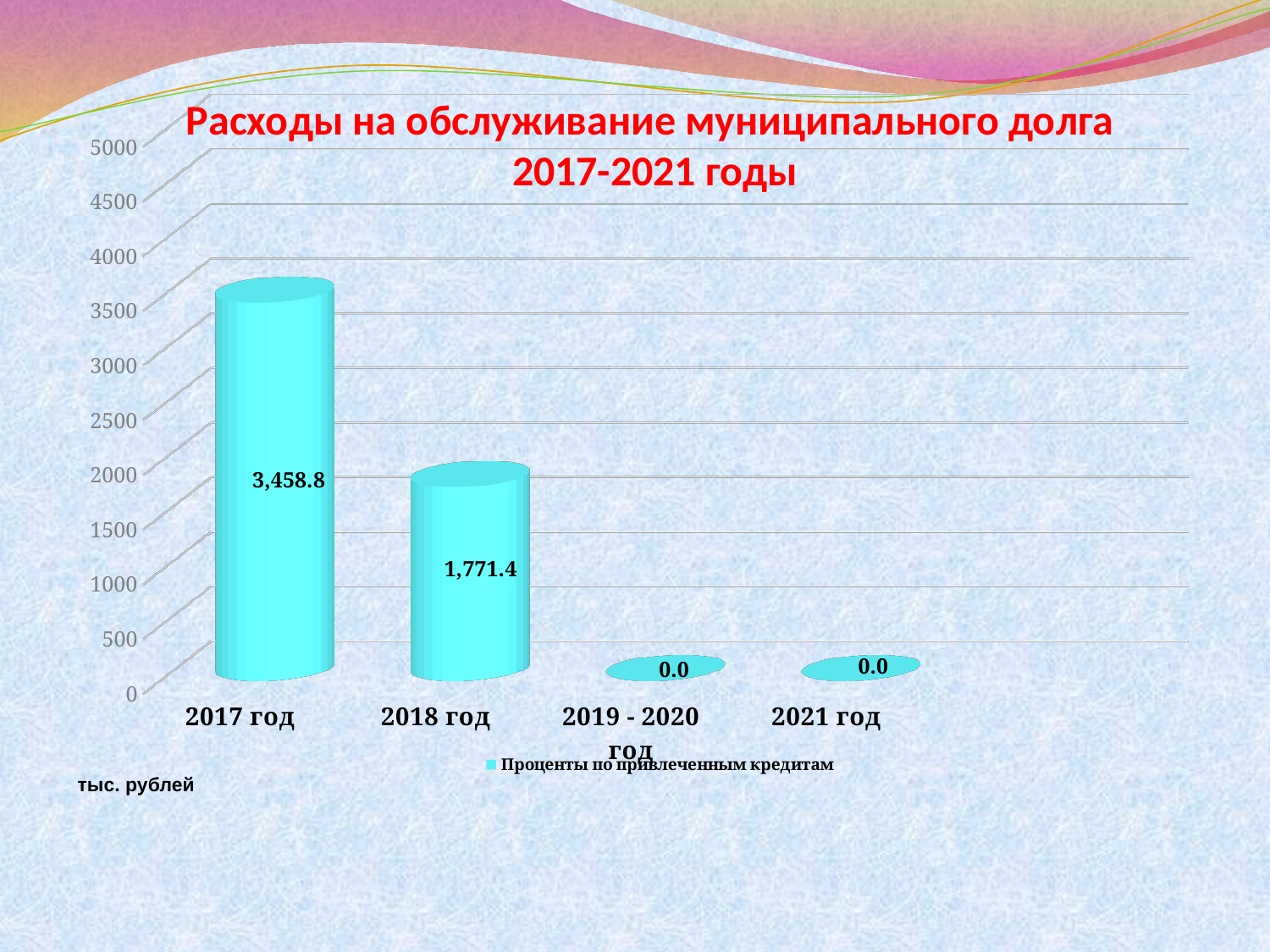
What is the value for 2018 год? 1,771.4 What is the difference between the values for 2017 год and 2018 год? 1,687.4 What is the value for 2017 год? 3,458.8 Which is larger, the value for 2017 год or the value for 2018 год? 2017 год Do the values rise or fall from 2017 год to 2021 год? fall How many categories are shown on the x axis? 4 How many series does the legend list? 1 Is the value for 2017 год greater or less than 3000? greater What kind of chart is shown? bar chart What is the value for 2021 год? 0.0 Which category has the highest value? 2017 год Is the value for 2018 год greater or less than 2000? less